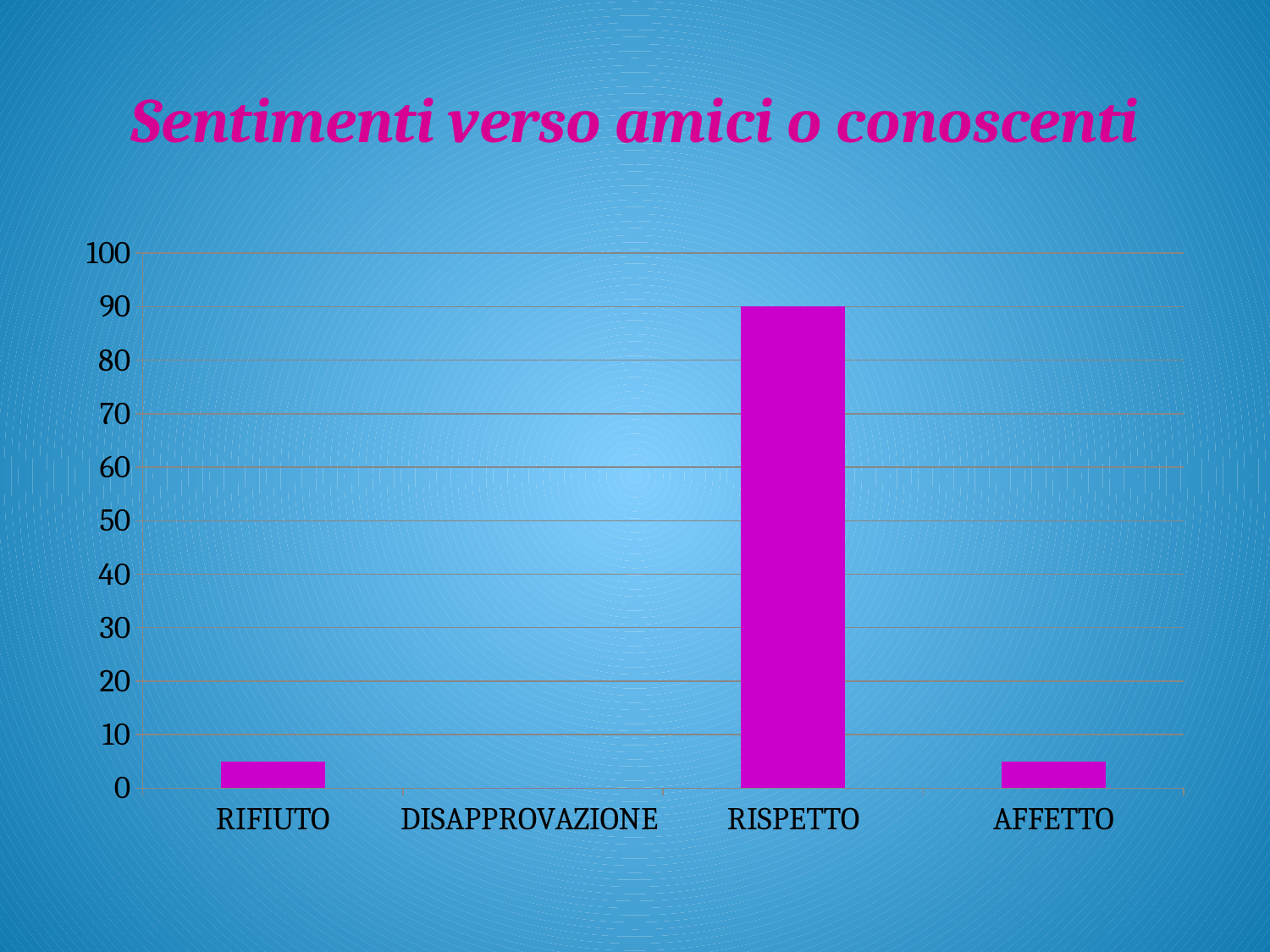
Is the value for RIFIUTO greater or less than 10? less Is the value for RISPETTO greater or less than 80? greater Which category has the lowest value? DISAPPROVAZIONE How many categories are shown on the x axis? 4 Is the value for DISAPPROVAZIONE greater or less than 10? less What is the title of the slide? Sentimenti verso amici o conoscenti Which category has the highest value? RISPETTO Which is larger, the value for RISPETTO or the value for AFFETTO? RISPETTO What kind of chart is shown on the slide? bar chart Which is larger, the value for RIFIUTO or the value for RISPETTO? RISPETTO What is the value for RISPETTO? 90